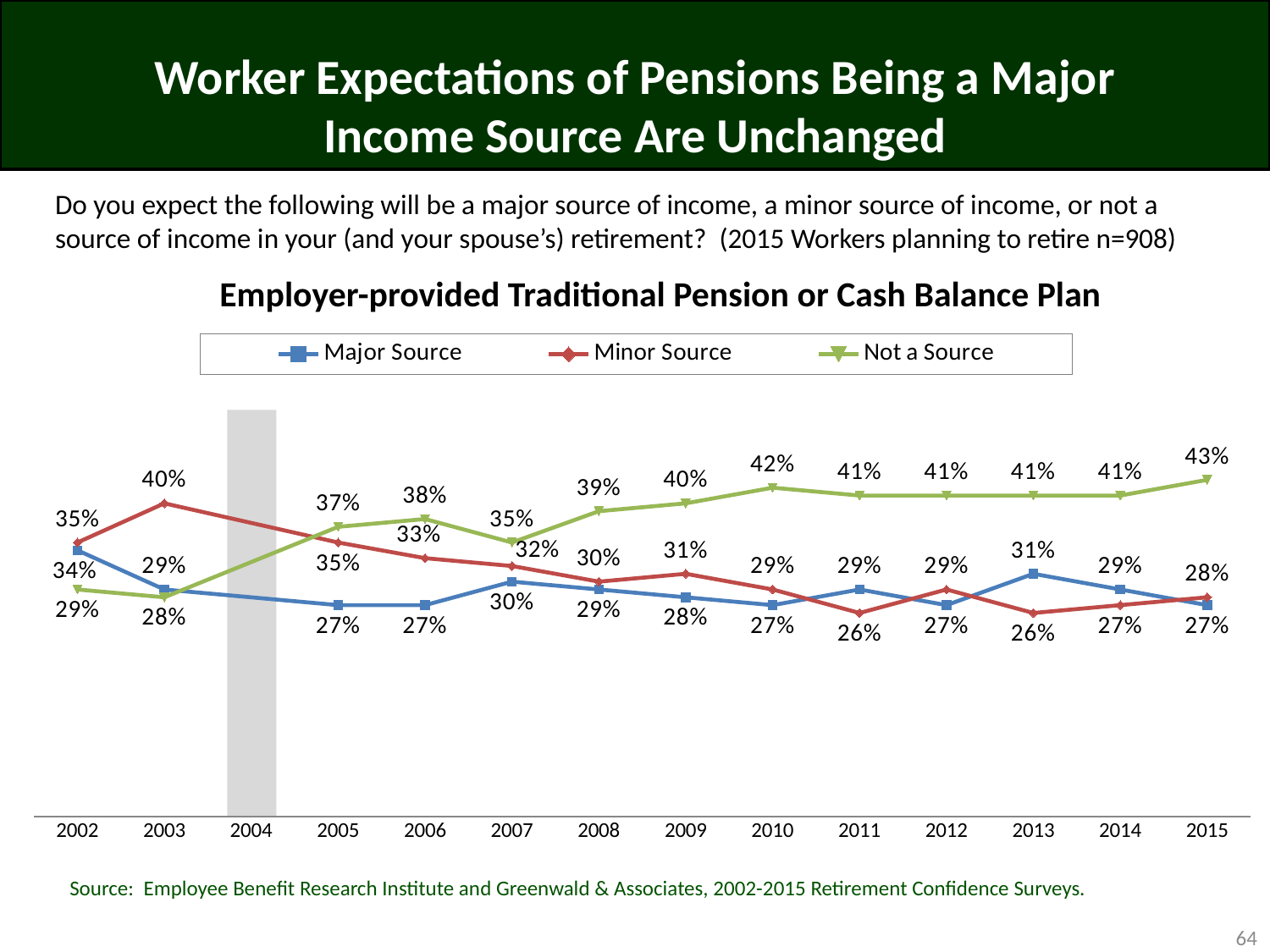
What is the value for Major Source in 2013? 31% What type of chart is shown on the slide? Line chart What is the difference between Minor Source in 2003 and Minor Source in 2015? 12 percentage points What is the value for Minor Source in 2003? 40% What is the difference between Not a Source and Major Source in 2015? 16 percentage points Does the Not a Source series generally rise or fall from 2005 to 2015? Rise In which year does the Minor Source series reach its highest value? 2003 What is the title of the chart? Employer-provided Traditional Pension or Cash Balance Plan Which is larger in 2002, Major Source or Minor Source? Minor Source How many series does the legend list? 3 What is the value for Not a Source in 2015? 43% In which year does the Not a Source series reach its highest value? 2015